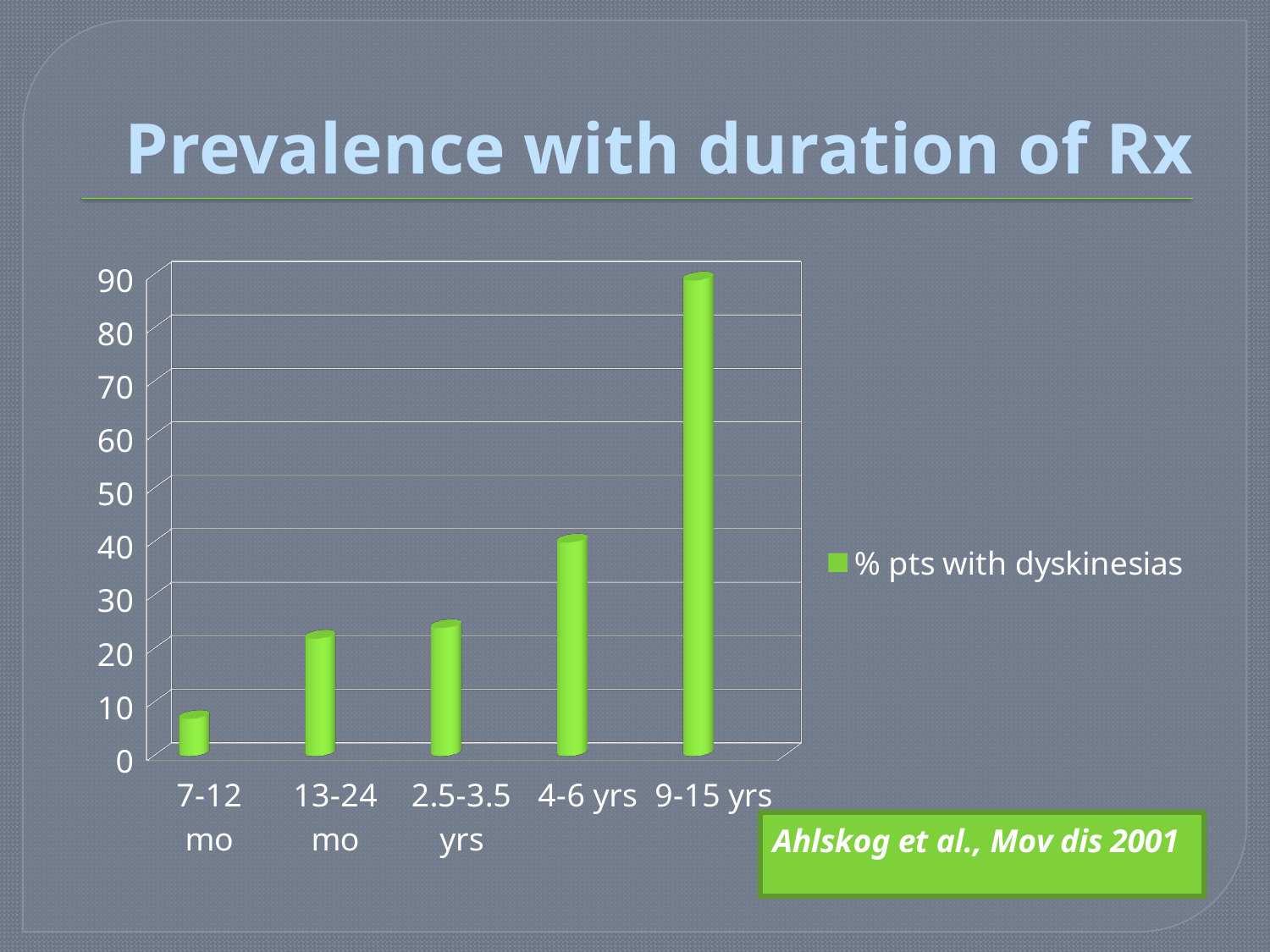
How many series does the chart's legend list? 1 Which category has the lowest value? 7-12 mo What is the title of the slide containing the chart? Prevalence with duration of Rx Which is larger, the value for 4-6 yrs or the value for 2.5-3.5 yrs? 4-6 yrs Is the value for 13-24 mo greater or less than 30? less Which category has the highest value? 9-15 yrs Do the values rise or fall as duration of treatment increases along the x axis? rise Is the value for 7-12 mo greater or less than 10? less Is the value for 9-15 yrs greater or less than 80? greater What kind of chart is shown on the slide? bar chart How many categories are shown on the x axis of the chart? 5 What is the name of the series shown in the legend? % pts with dyskinesias